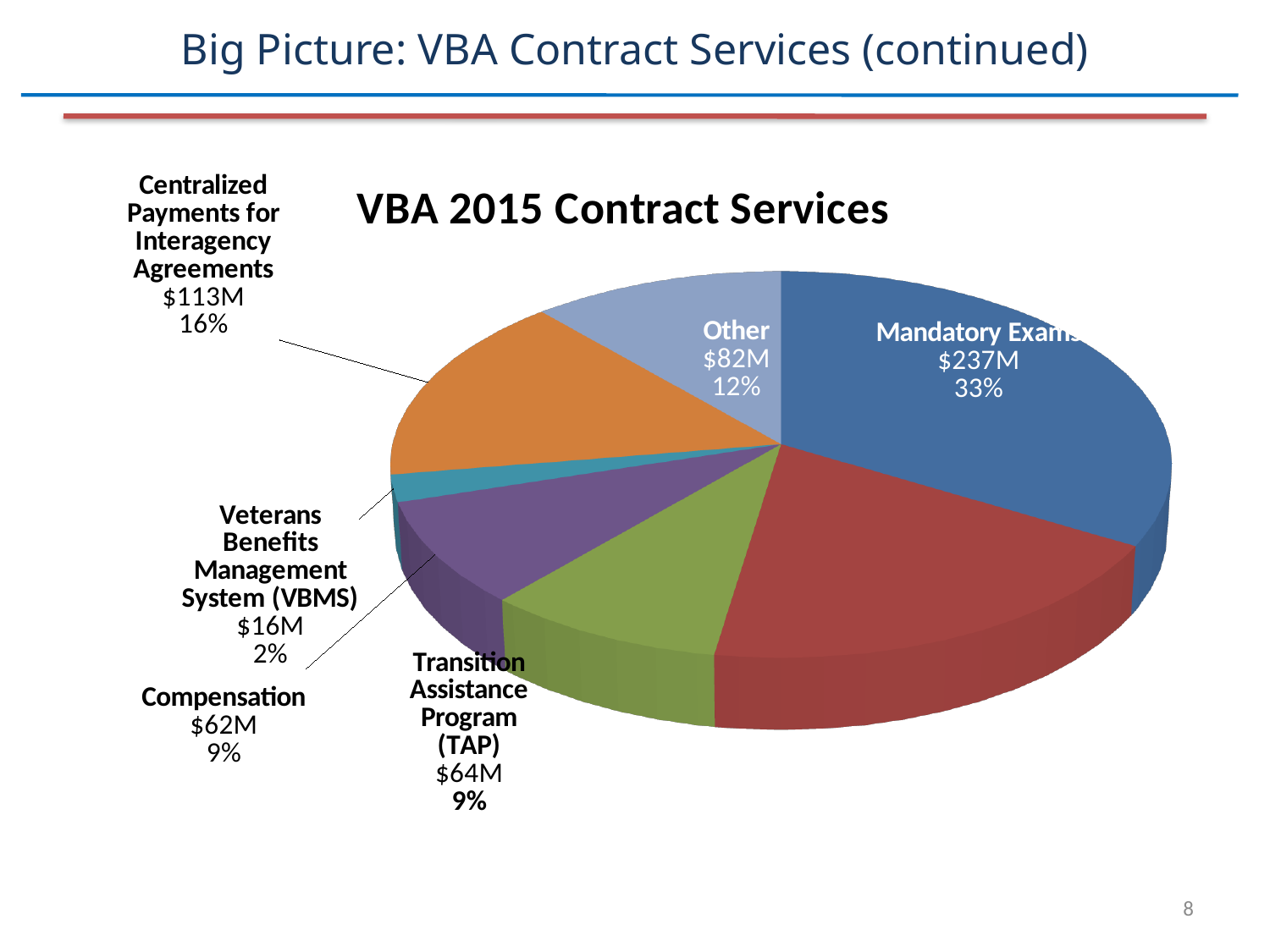
What is the difference in dollar value between Centralized Payments for Interagency Agreements and Compensation? $51M What type of chart is shown on the slide? pie chart What is the dollar value for Mandatory Exams? $237M Which has a larger dollar value, Transition Assistance Program (TAP) or Compensation? Transition Assistance Program (TAP) What share of the pie does Other represent? 12% What is the title of the chart? VBA 2015 Contract Services What is the dollar value for Centralized Payments for Interagency Agreements? $113M What share of the pie does Centralized Payments for Interagency Agreements represent? 16% Which labeled category has the largest slice? Mandatory Exams What is the difference in dollar value between Mandatory Exams and Other? $155M What is the dollar value for Veterans Benefits Management System (VBMS)? $16M Which labeled category has the smallest slice? Veterans Benefits Management System (VBMS)